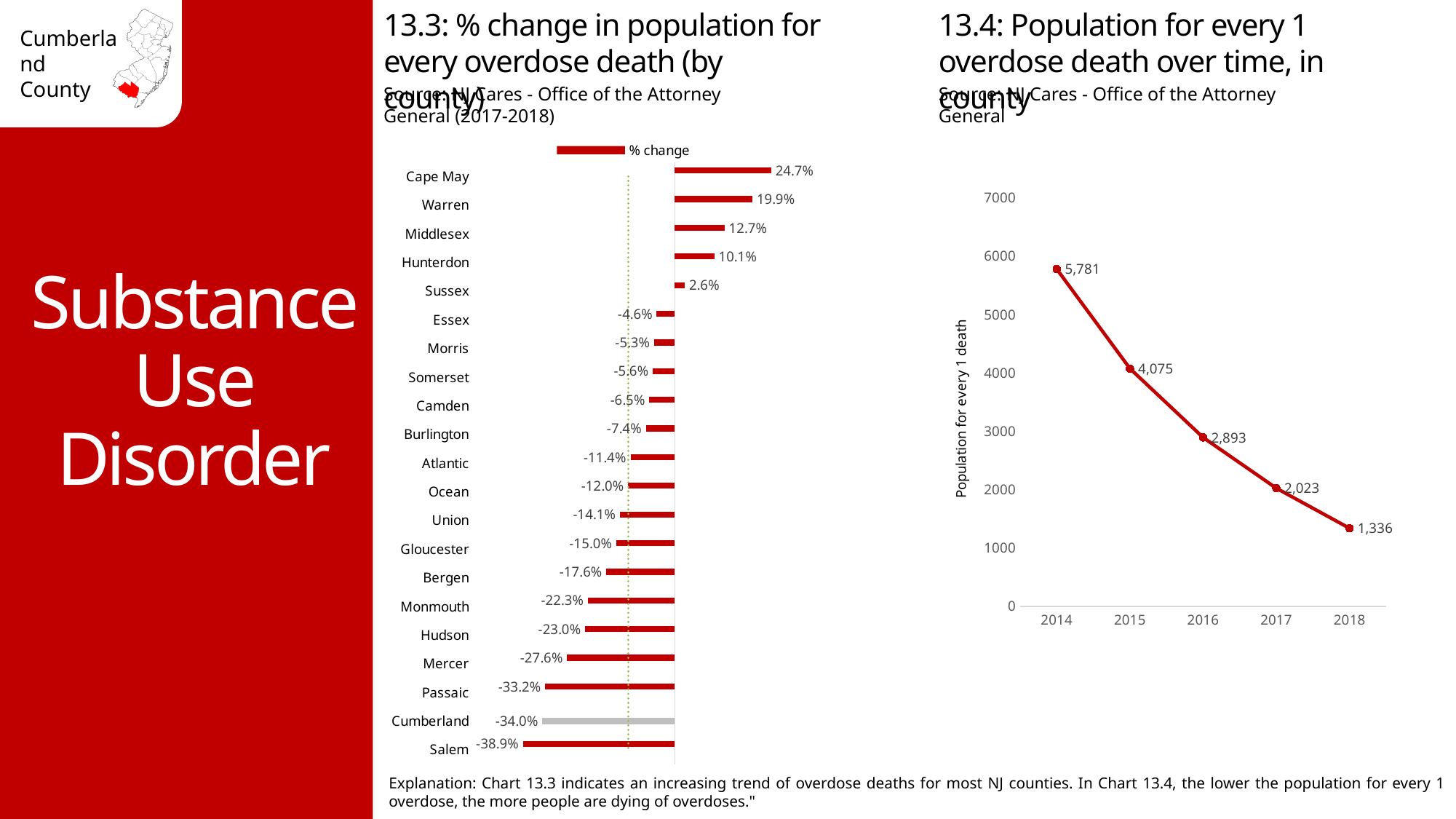
In chart 13.3, which county has the highest % change? Cape May In chart 13.3, which has a larger % change, Hudson or Mercer? Hudson What kind of chart is chart 13.4? Line chart In chart 13.3, what is the % change for Cumberland? -34.0% In chart 13.3, what is the % change for Cape May? 24.7% In chart 13.4, what is the difference between the 2014 and 2018 values? 4,445 What kind of chart is chart 13.3? Bar chart In chart 13.4, what is the population for every 1 overdose death in 2016? 2,893 In chart 13.3, which county has the lowest % change? Salem In chart 13.4, how does the population for every 1 overdose death change from 2014 to 2018? It falls In chart 13.3, how many counties are listed? 21 In chart 13.3, what is the difference between the % change for Warren and Middlesex? 7.2 percentage points